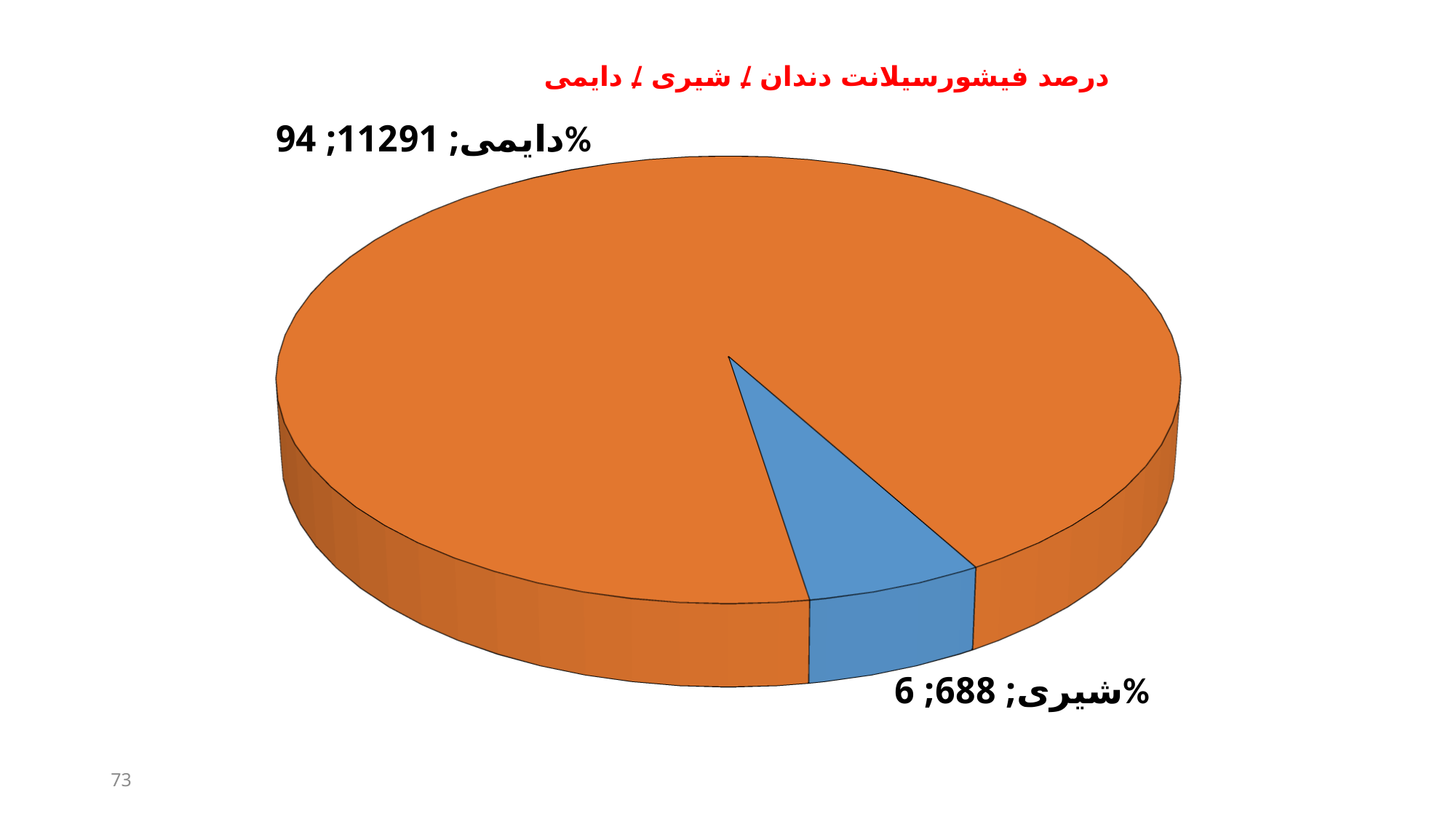
How many slices does the pie chart have? 2 What is the value shown for the دایمی slice? 11291 What is the value shown for the شیری slice? 688 What percentage share of the pie does the دایمی slice represent? 94% What is the total of the two slice values in the pie chart? 11979 What is the difference between the values for دایمی and شیری? 10603 Which slice is the smallest in the pie chart? شیری What kind of chart is shown on the slide? Pie chart What colour is the شیری slice? Blue Which slice is the largest in the pie chart? دایمی Which is larger, the value for دایمی or the value for شیری? دایمی What percentage share of the pie does the شیری slice represent? 6%